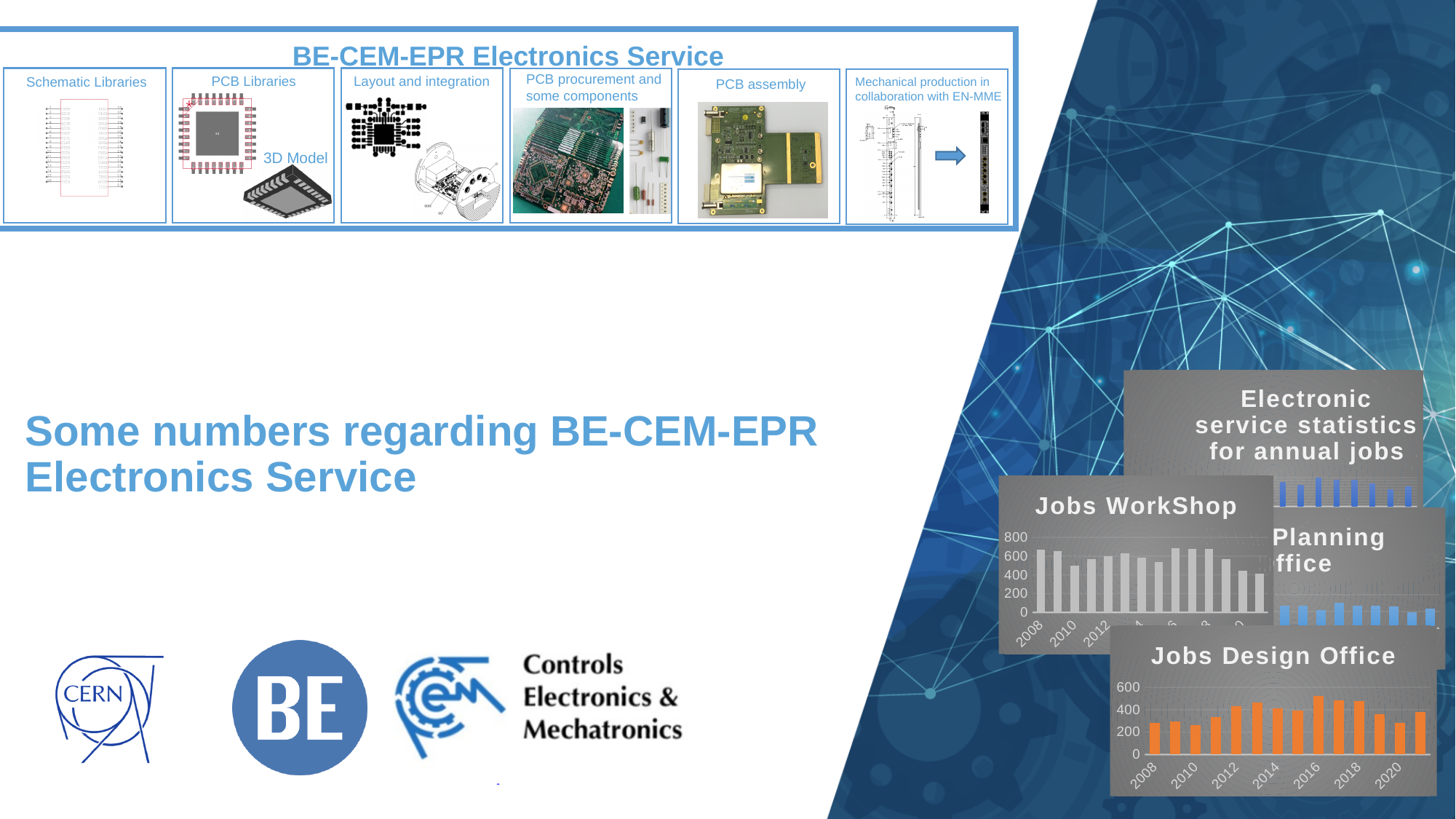
In the "Jobs Design Office" chart, is the value for 2016 greater or less than 400? greater What is the highest value shown on the y axis of the "Jobs WorkShop" chart? 800 In the "Jobs WorkShop" chart, is the value for 2008 greater or less than 400? greater In the "Jobs Design Office" chart, is the value for 2008 greater or less than 400? less In the "Jobs Design Office" chart, is the value for 2016 larger or smaller than the value for 2008? larger In the "Jobs Design Office" chart, do the values generally rise or fall from 2008 to 2016? rise In the "Jobs Design Office" chart, which year has the highest bar? 2016 What colour are the bars in the "Jobs Design Office" chart? orange What kind of chart is the "Jobs WorkShop" chart? bar chart What kind of chart is the "Jobs Design Office" chart? bar chart